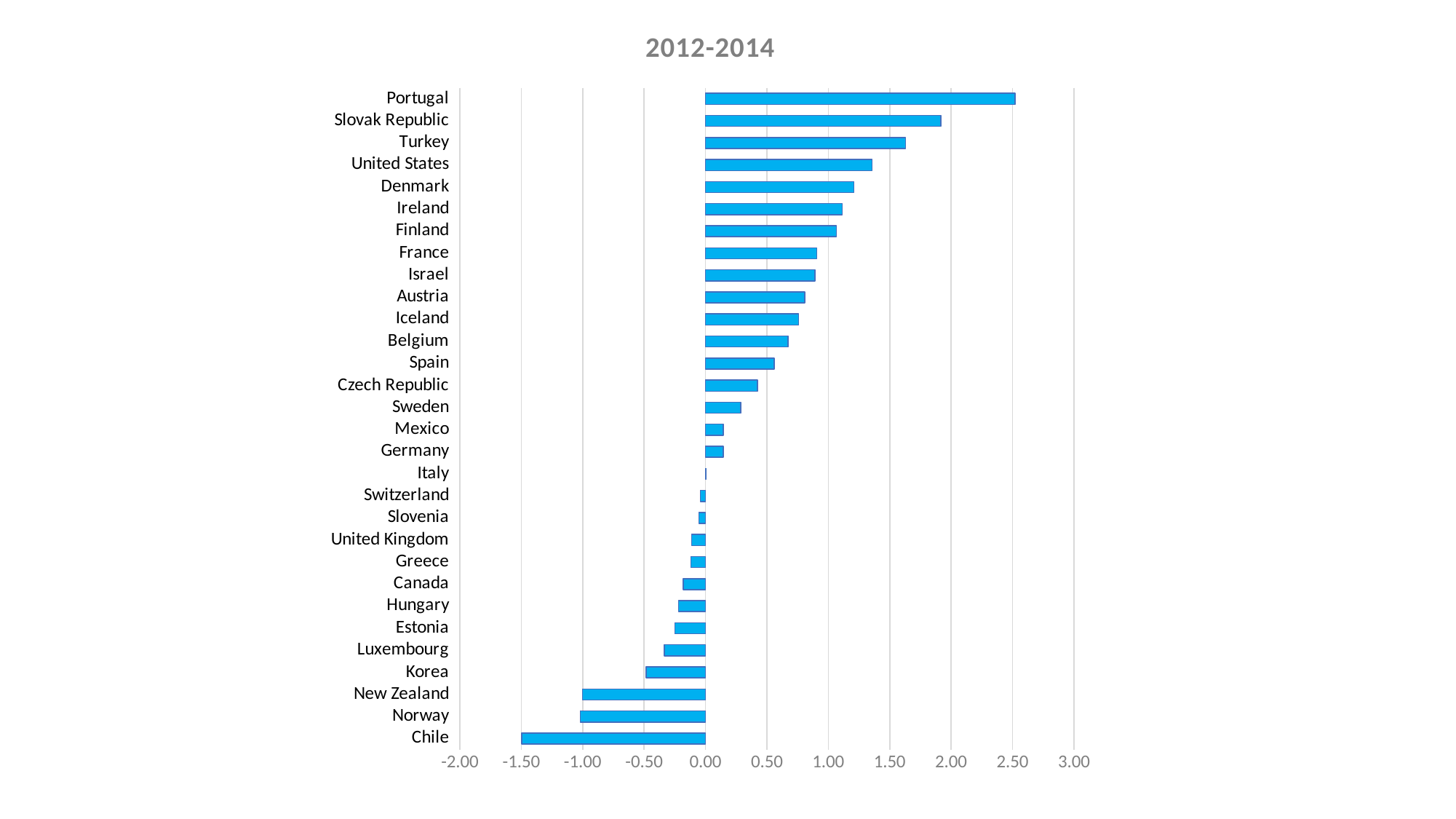
Is the value for Chile greater or less than -1.00? less Is the value for Portugal greater or less than 2.00? greater What kind of chart is shown on the slide? bar chart Is the value for United States greater or less than 1.50? less Which country has the highest value in the chart? Portugal Which country has the lowest value in the chart? Chile What is the title of the chart? 2012-2014 How many countries are plotted in the chart? 30 Do the values rise or fall going from the top of the chart (Portugal) to the bottom (Chile)? fall Which has the larger value, Turkey or United States? Turkey